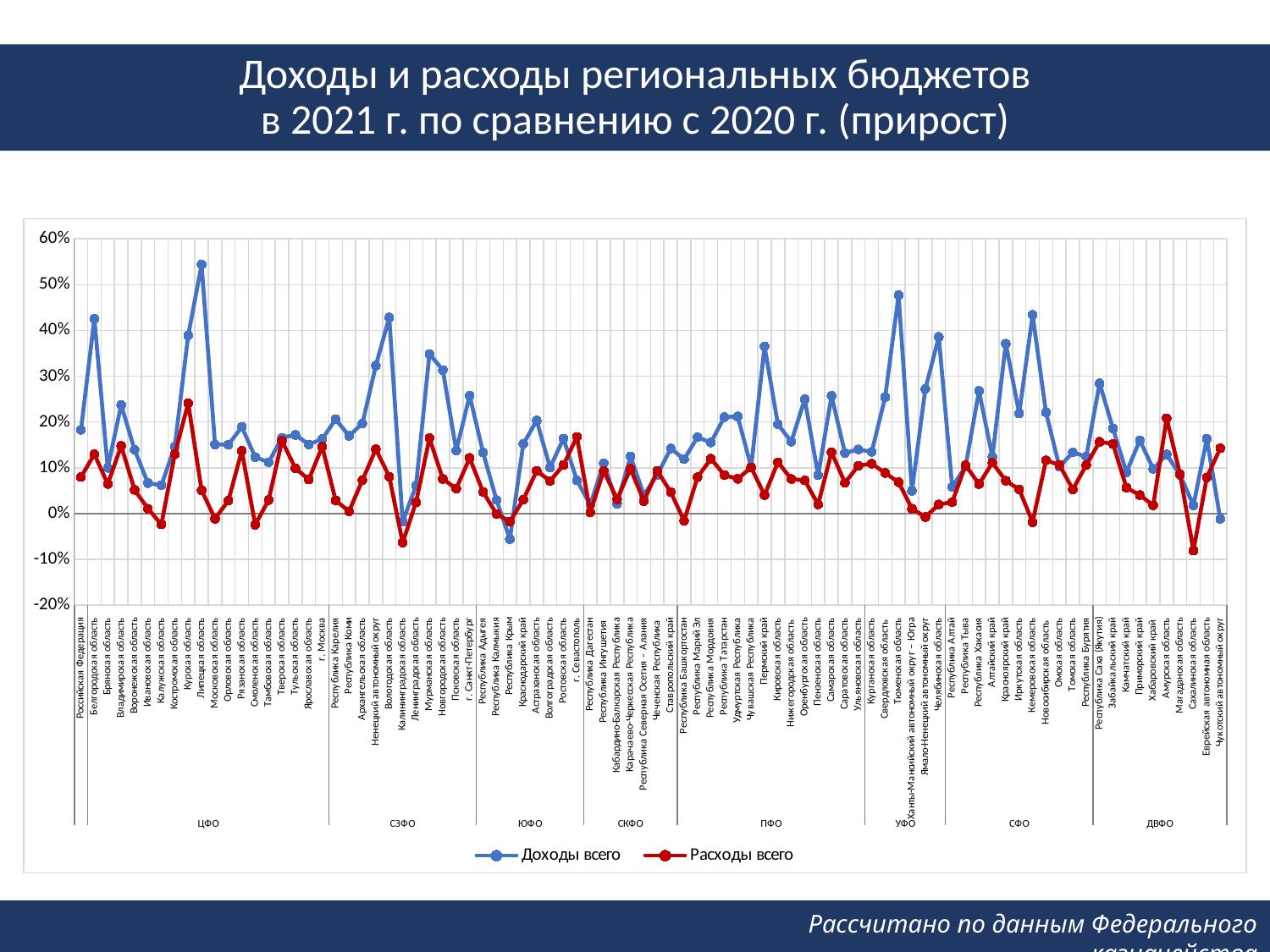
What are the two series named in the legend? Доходы всего and Расходы всего For Липецкая область, which is larger: Доходы всего or Расходы всего? Доходы всего Is the Расходы всего value for Сахалинская область greater or less than 0%? less How many series does the legend list? 2 Which region has the highest value for Доходы всего? Липецкая область How many federal district groups (ЦФО, СЗФО, etc.) are labelled along the x axis? 8 For Амурская область, which is larger: Доходы всего or Расходы всего? Расходы всего Is the Расходы всего value for Российская Федерация greater or less than 10%? less Is the Доходы всего value for Липецкая область greater or less than 50%? greater What kind of chart is shown on the slide? Line chart Which colour is used for the Доходы всего series? Blue